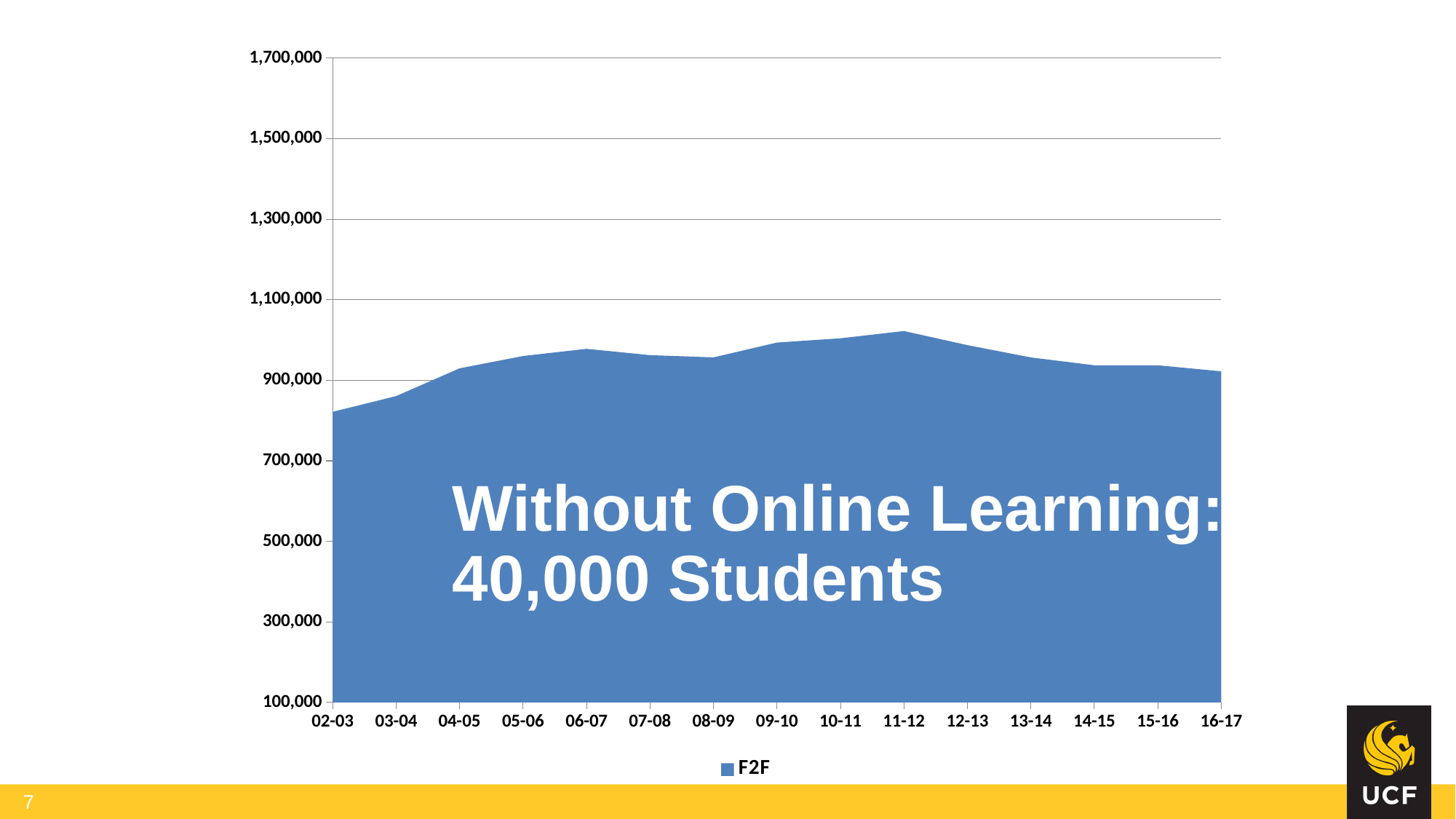
How many series does the legend list? 1 In which academic year is the F2F series at its lowest value? 02-03 Is the F2F value for 06-07 greater or less than 900,000? greater Does the F2F series rise or fall from 11-12 to 16-17? Fall Is the F2F value for 11-12 greater or less than 1,100,000? less What text is overlaid on the chart area? Without Online Learning: 40,000 Students What kind of chart is shown on the slide? Area chart Is the F2F value for 02-03 greater or less than 900,000? less What is the name of the series shown in the legend? F2F How many academic years are shown along the x axis? 15 In which academic year does the F2F series reach its highest value? 11-12 Which year has the larger F2F value, 02-03 or 11-12? 11-12